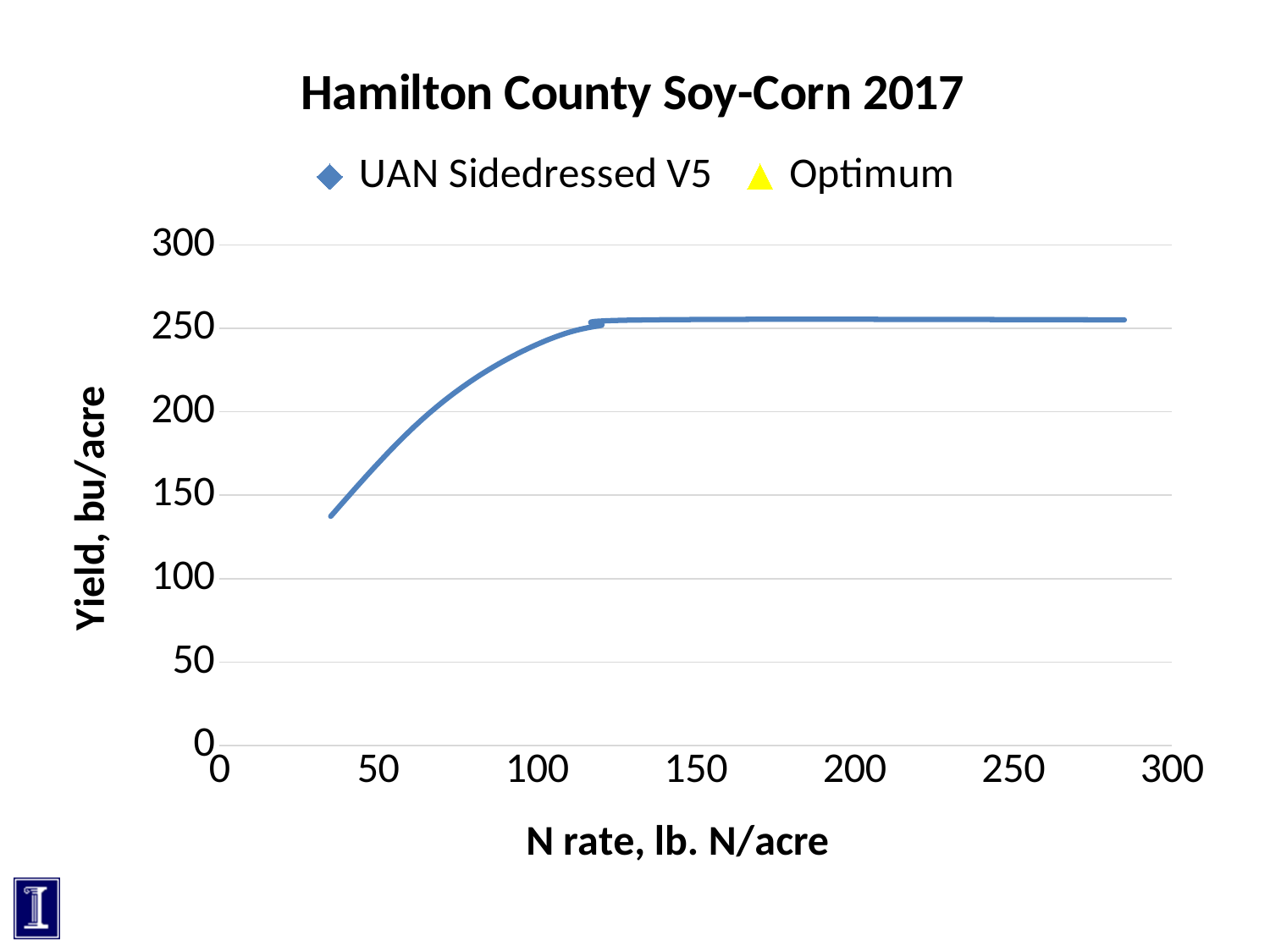
What are the two series named in the legend? UAN Sidedressed V5 and Optimum Do the yield values for UAN Sidedressed V5 rise or fall as the N rate increases from 50 to 100? rise What is the title of the chart? Hamilton County Soy-Corn 2017 Is the yield for UAN Sidedressed V5 at an N rate of 100 greater or less than 200? greater Is the yield for UAN Sidedressed V5 at an N rate of 200 greater or less than 200? greater Is the maximum yield reached by the UAN Sidedressed V5 curve greater or less than 300? less How many series does the legend list? 2 What kind of chart is shown on the slide? line chart Which has the higher yield for UAN Sidedressed V5: an N rate of 50 or an N rate of 150? 150 What is the label of the y axis? Yield, bu/acre